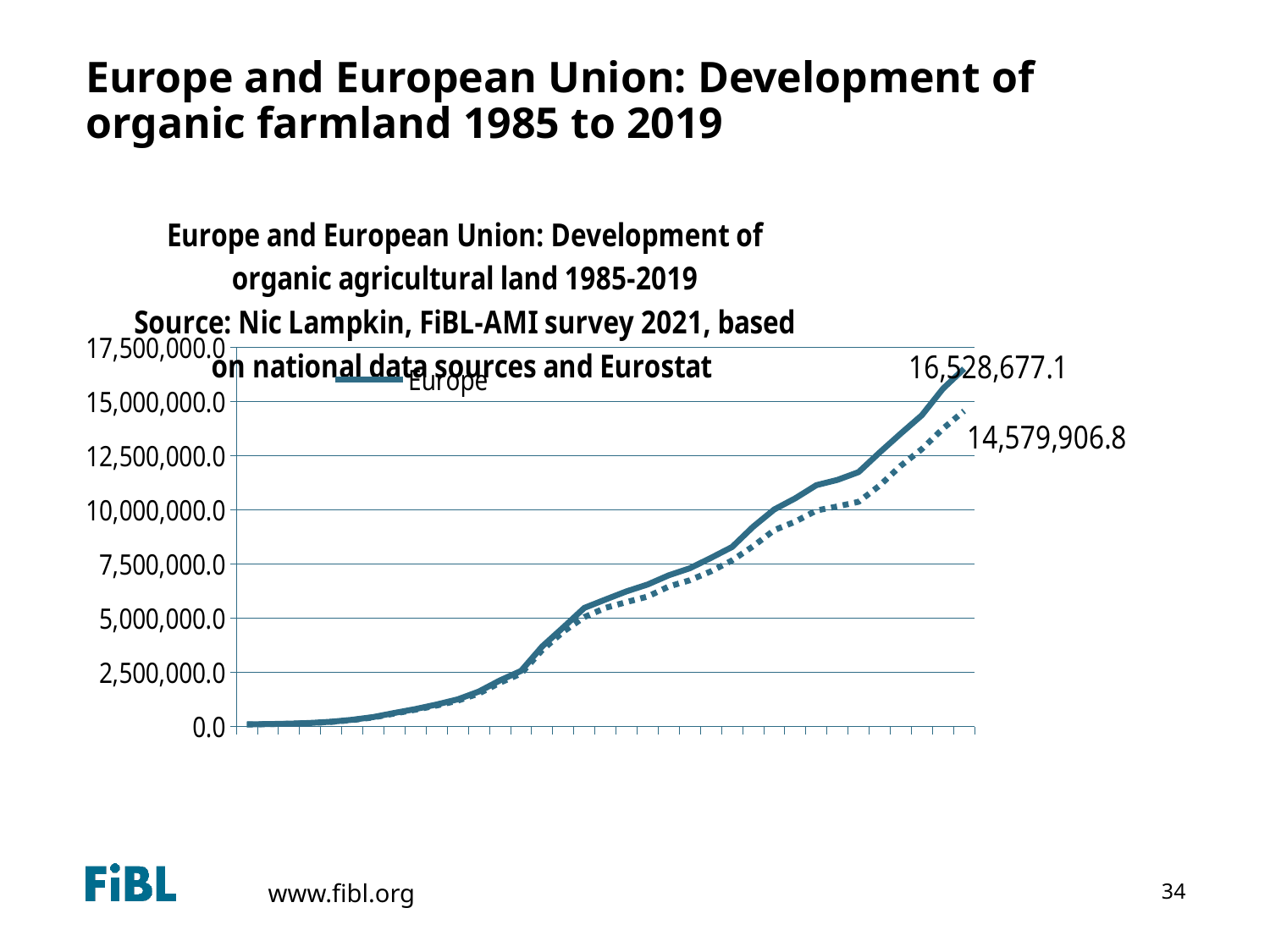
Which series name is readable in the chart legend? Europe What is the highest value shown on the y axis? 17,500,000.0 Do the values rise or fall along the x axis from 1985 to 2019? rise Is the final value of the dotted line greater or less than 15,000,000.0? less Is the final value of the Europe line greater or less than 15,000,000.0? greater How many lines are plotted on the chart? 2 What is the final value shown for the dotted line? 14,579,906.8 What is the final value shown for the Europe (solid) line? 16,528,677.1 What is the difference between the two data labels shown at the end of the lines, 16,528,677.1 and 14,579,906.8? 1,948,770.3 What kind of chart is shown on the slide? line chart Which line ends at a higher value, the solid Europe line or the dotted line? the solid Europe line